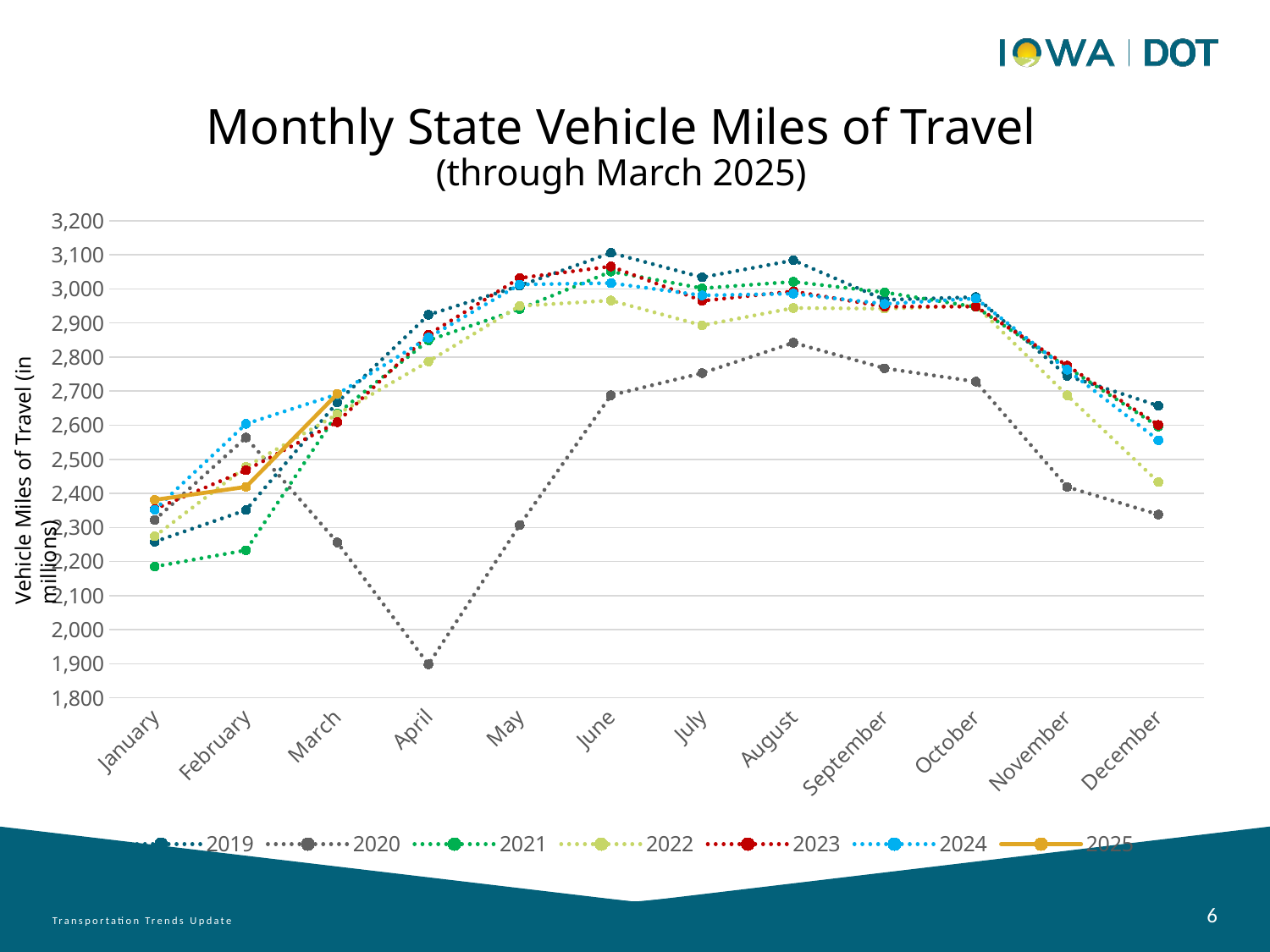
How many months are shown along the x axis? 12 Is the value for 2025 in March greater or less than 2,600? greater How many data points are plotted for the 2025 series? 3 Is the value for 2021 in January greater or less than 2,300? less Is the value for 2020 in April greater or less than 2,000? less Do the values for the 2025 series rise or fall from January to March? rise Which series has the higher value in June, 2019 or 2020? 2019 What kind of chart is shown on the slide? line chart In which month does the 2020 series reach its lowest value? April How many series does the legend list? 7